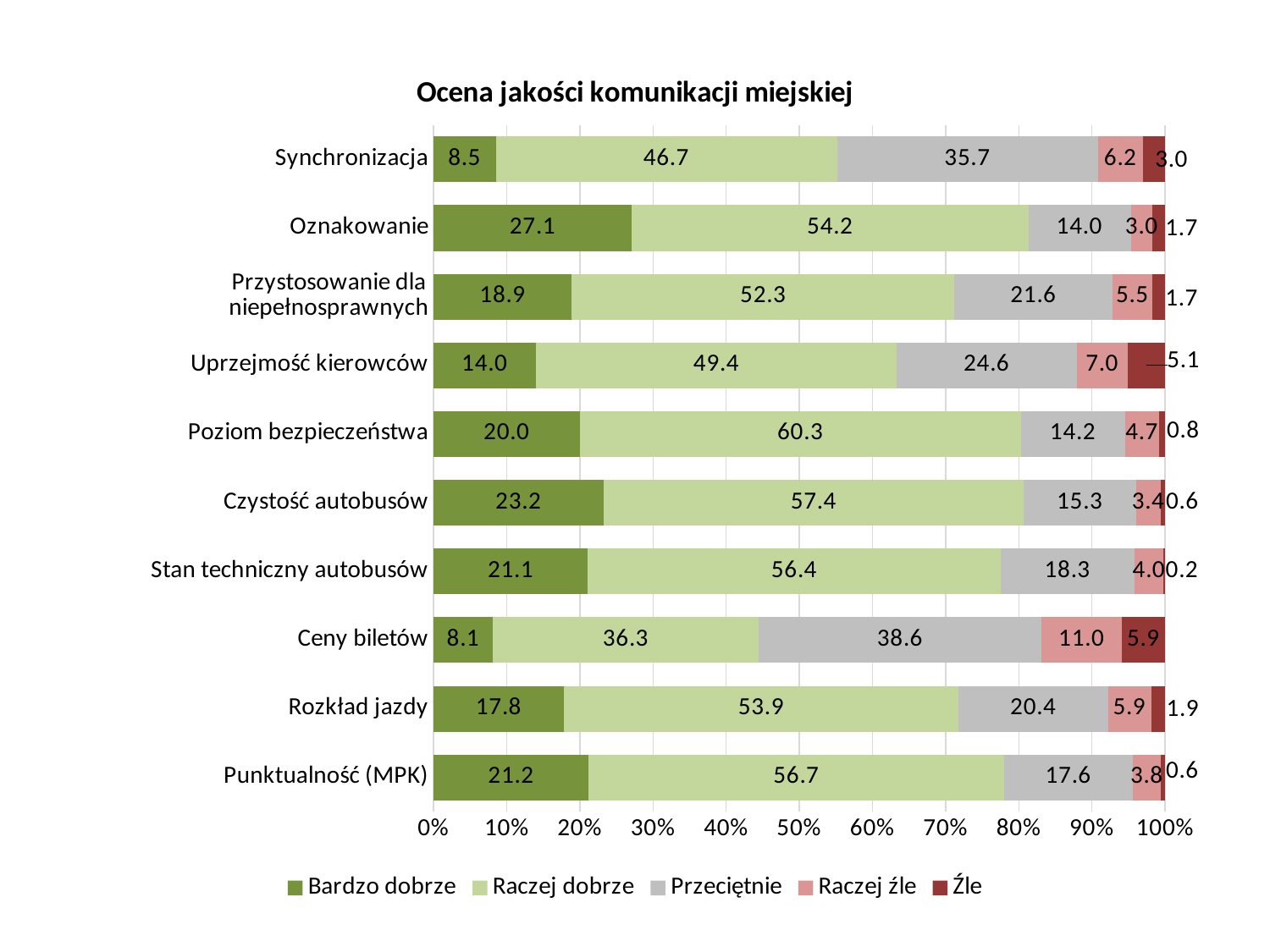
What kind of chart is shown on the slide? Stacked bar chart What is the value of "Przeciętnie" for Ceny biletów? 38.6 Which category has the highest "Raczej dobrze" value? Poziom bezpieczeństwa Which category has the lowest "Źle" value? Stan techniczny autobusów What is the title of the chart? Ocena jakości komunikacji miejskiej How many categories are shown on the chart? 10 How many series does the legend list? 5 What is the value of "Bardzo dobrze" for Oznakowanie? 27.1 Which has the larger "Raczej źle" value: Ceny biletów or Uprzejmość kierowców? Ceny biletów What is the difference between the "Raczej dobrze" values for Poziom bezpieczeństwa and Ceny biletów? 24.0 What is the value of "Źle" for Uprzejmość kierowców? 5.1 Which category has the highest "Bardzo dobrze" value? Oznakowanie